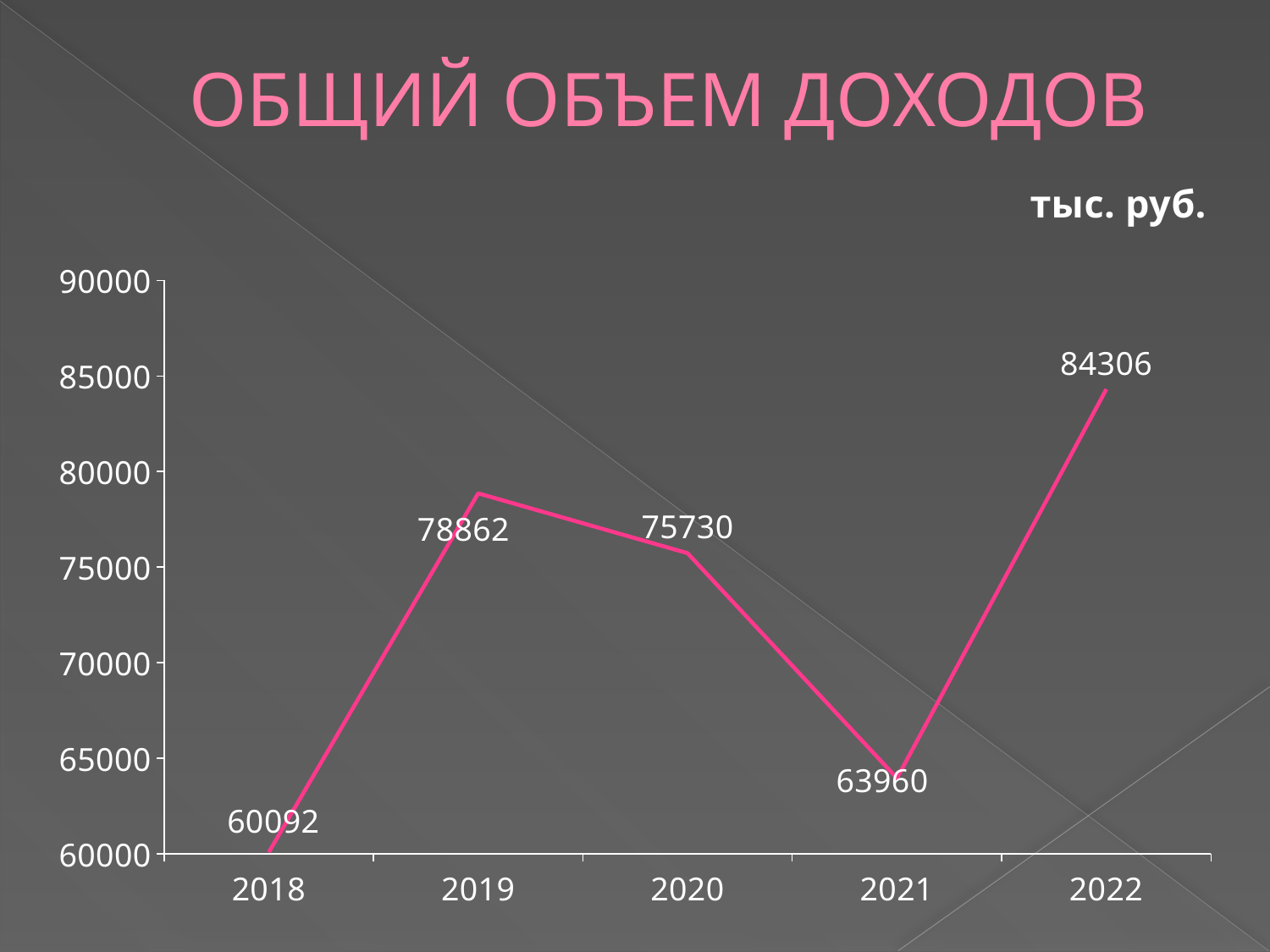
What is the value for 2018? 60092 Is the value for 2020 greater or less than 70000? greater What is the difference between the values for 2019 and 2020? 3132 Which is larger, the value for 2019 or the value for 2020? 2019 Which year has the lowest value? 2018 Which year has the highest value? 2022 How many years are plotted on the chart? 5 What is the value for 2021? 63960 What is the difference between the values for 2022 and 2021? 20346 What kind of chart is shown on the slide? line chart What is the value for 2019? 78862 What is the value for 2022? 84306